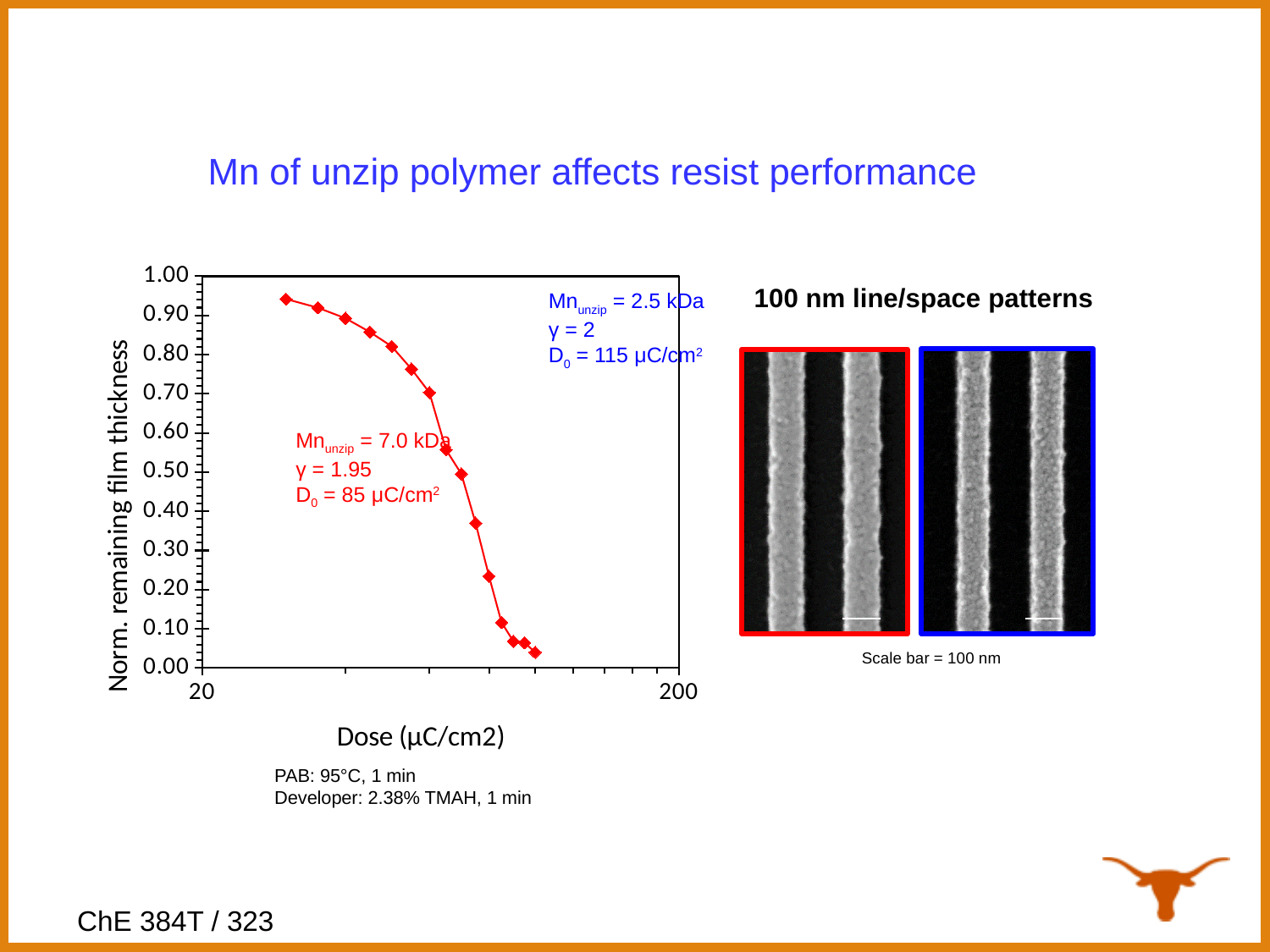
Is the highest plotted normalized film thickness greater or less than 0.90? greater Which resist has the larger D0, Mn_unzip = 7.0 kDa or Mn_unzip = 2.5 kDa? Mn_unzip = 2.5 kDa What is the label of the x axis of the chart? Dose (µC/cm2) What kind of chart is shown on the slide? scatter (line) chart Is the lowest plotted normalized film thickness greater or less than 0.10? less What is the D0 value given for the Mn_unzip = 7.0 kDa resist? 85 µC/cm² What is the difference between the D0 values of the 2.5 kDa and 7.0 kDa resists? 30 µC/cm² What is the label of the y axis of the chart? Norm. remaining film thickness What is the D0 value given for the Mn_unzip = 2.5 kDa resist? 115 µC/cm² As dose increases along the x axis, does the normalized remaining film thickness rise or fall? fall Is the normalized film thickness of the first (leftmost) data point greater or less than 1.00? less What is the γ value given for the Mn_unzip = 7.0 kDa resist? 1.95